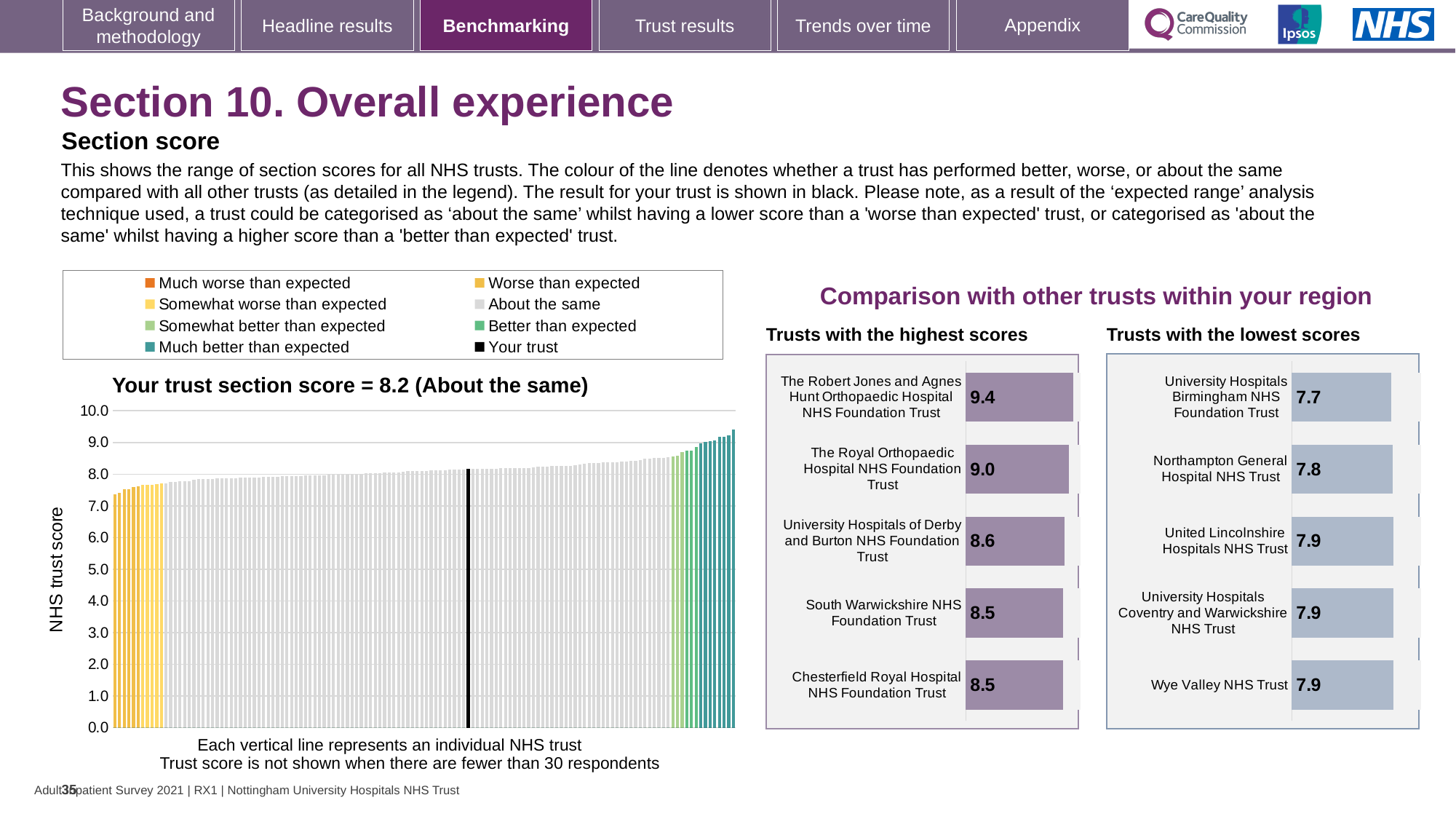
In the chart titled 'Your trust section score', is the value of the leftmost bar greater or less than 8.0? less In the chart 'Trusts with the highest scores', what is the difference between the scores of The Robert Jones and Agnes Hunt Orthopaedic Hospital NHS Foundation Trust and University Hospitals of Derby and Burton NHS Foundation Trust? 0.8 What kind of chart is the chart titled 'Your trust section score'? bar chart How many trusts are shown in the chart 'Trusts with the lowest scores'? 5 In the chart titled 'Your trust section score', what category is your trust placed in? About the same In the chart titled 'Your trust section score', do the bars rise or fall from left to right? rise In the chart 'Trusts with the highest scores', which trust has the highest score? The Robert Jones and Agnes Hunt Orthopaedic Hospital NHS Foundation Trust In the chart 'Trusts with the highest scores', what is the score for The Royal Orthopaedic Hospital NHS Foundation Trust? 9.0 In the chart titled 'Your trust section score', what is the section score for your trust? 8.2 In the chart 'Trusts with the lowest scores', which trust has the lowest score? University Hospitals Birmingham NHS Foundation Trust In the chart 'Trusts with the lowest scores', what is the score for Northampton General Hospital NHS Trust? 7.8 How many entries does the legend above the chart titled 'Your trust section score' list? 8